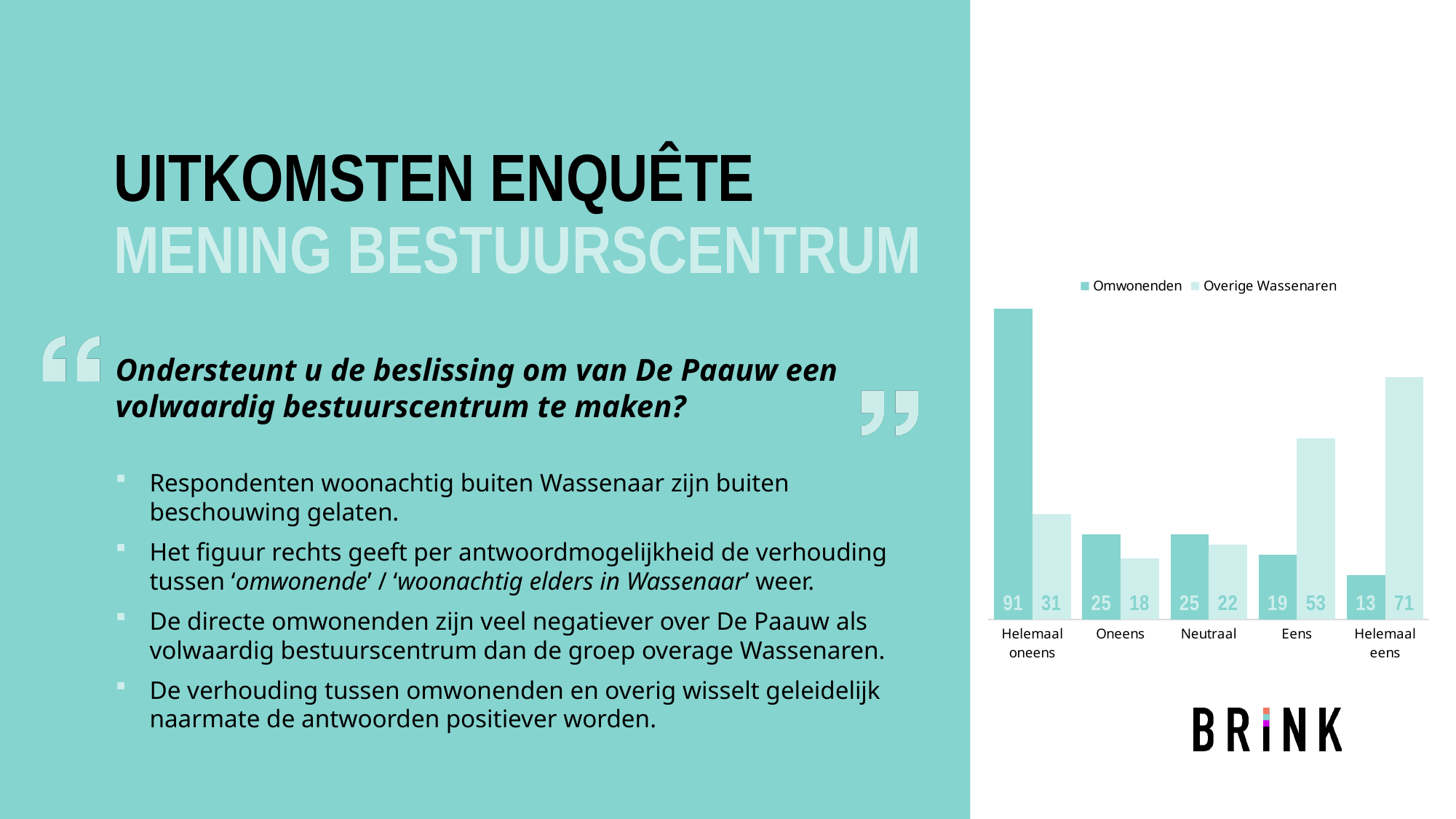
Which category has the lowest value for Overige Wassenaren? Oneens Do the Omwonenden values rise or fall from Helemaal oneens to Helemaal eens? Fall In the Eens category, which series has the larger value, Omwonenden or Overige Wassenaren? Overige Wassenaren What is the value for Overige Wassenaren in the Eens category? 53 What kind of chart is shown on the slide? Bar chart How many answer categories are shown on the x axis? 5 Which category has the highest value for Omwonenden? Helemaal oneens What is the difference between the Omwonenden and Overige Wassenaren values in the Helemaal oneens category? 60 What is the value for Overige Wassenaren in the Helemaal eens category? 71 How many series does the legend list? 2 What is the value for Omwonenden in the Neutraal category? 25 What is the value for Omwonenden in the Helemaal oneens category? 91